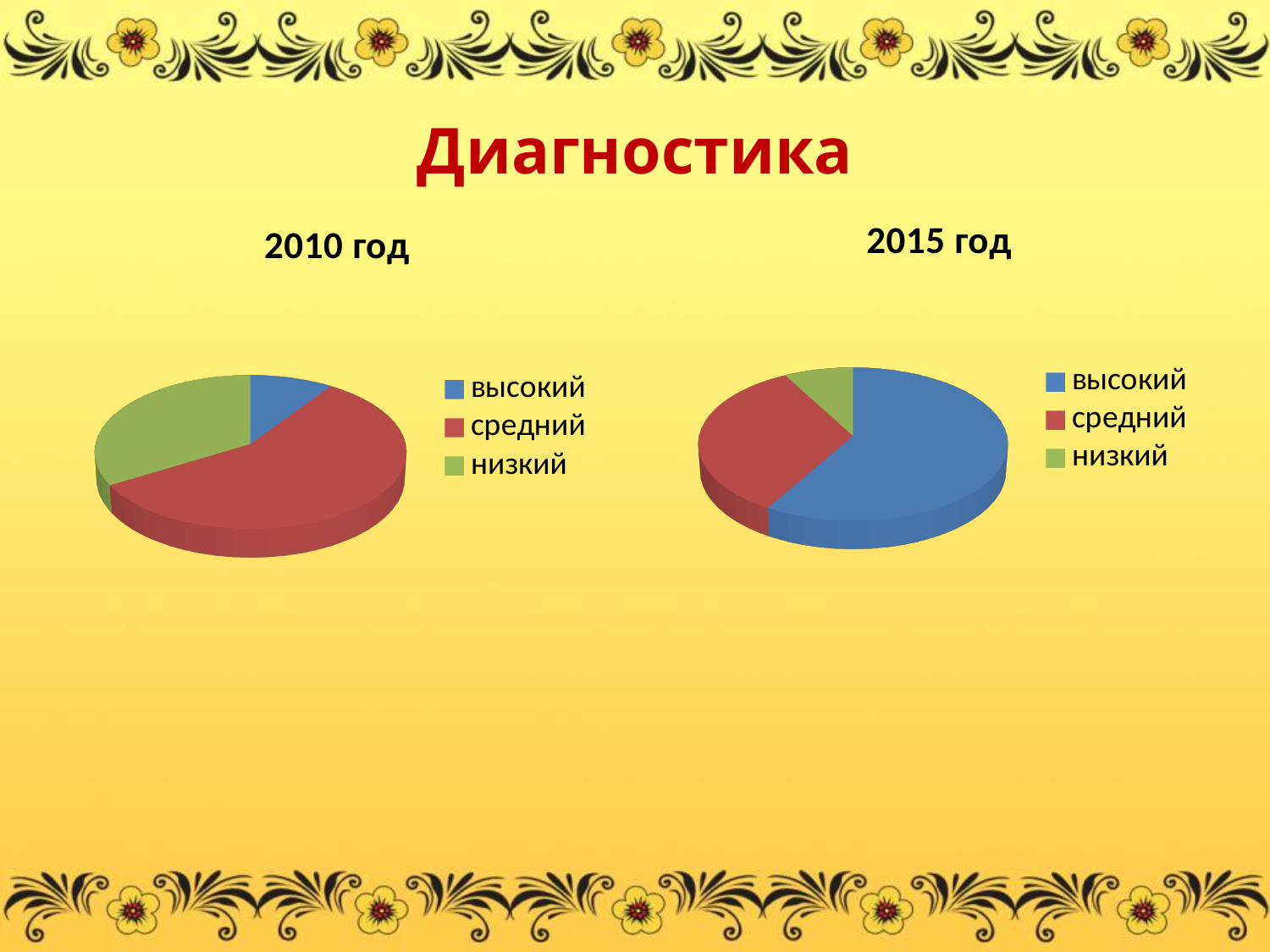
In the "2015 год" chart, which category has the largest slice? высокий What kind of chart is the "2015 год" chart? pie chart In the "2015 год" chart, what colour represents the category высокий? blue What is the title of the slide containing the two pie charts? Диагностика In the "2015 год" chart, which slice is larger: средний or низкий? средний In the "2010 год" chart, which category has the smallest slice? высокий In the "2010 год" chart, which category has the largest slice? средний What kind of chart is the "2010 год" chart? pie chart In the "2015 год" chart, which category has the smallest slice? низкий How many entries does the legend of the "2015 год" chart list? 3 How many slices does the "2010 год" pie chart have? 3 In the "2010 год" chart, which slice is larger: низкий or высокий? низкий